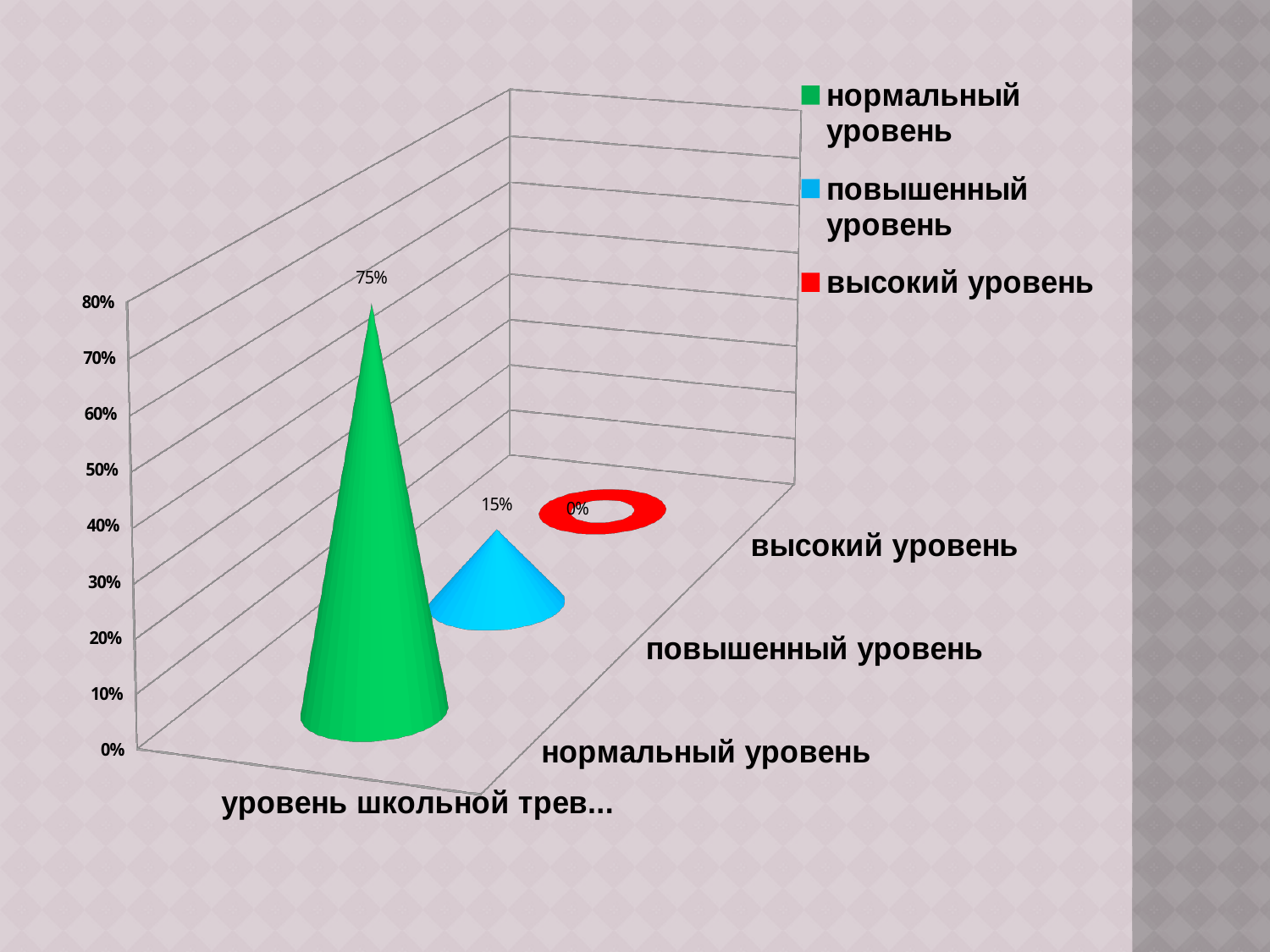
What is the value for высокий уровень? 0% How many categories are shown on the chart? 3 Which category has the highest value? нормальный уровень Which is larger, the value for повышенный уровень or the value for высокий уровень? повышенный уровень What is the value for нормальный уровень? 75% What is the difference between the values for нормальный уровень and повышенный уровень? 60% Is the value for нормальный уровень greater or less than 50%? greater How many entries does the legend list? 3 What is the value for повышенный уровень? 15% Which category has the lowest value? высокий уровень What colour represents высокий уровень in the legend? red What kind of chart is shown on the slide? bar chart